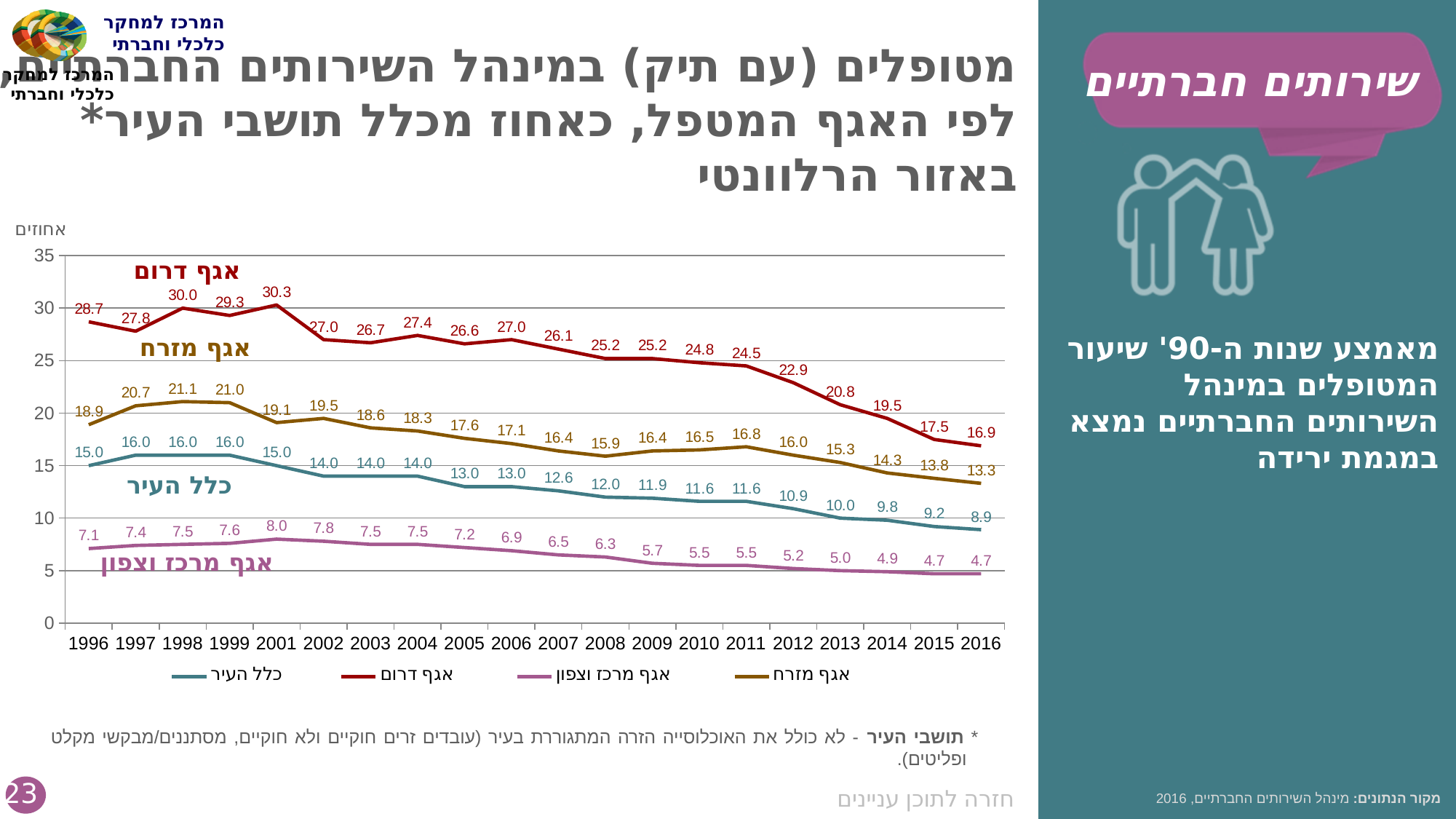
What is the difference between the אגף דרום value in 1996 and in 2016? 11.8 In which year does אגף דרום reach its highest value? 2001 In which year does אגף מזרח have its lowest value? 2016 What is the value for כלל העיר in 2008? 12.0 What is the value for אגף דרום in 2001? 30.3 How many years are shown on the x axis? 20 How many series does the legend list? 4 What kind of chart is shown on the slide? Line chart What is the value for אגף מרכז וצפון in 2016? 4.7 Does the value for כלל העיר rise or fall from 2001 to 2016? Fall What is the value for אגף מזרח in 1998? 21.1 Which is larger in 2011: the value for אגף מזרח or the value for כלל העיר? אגף מזרח